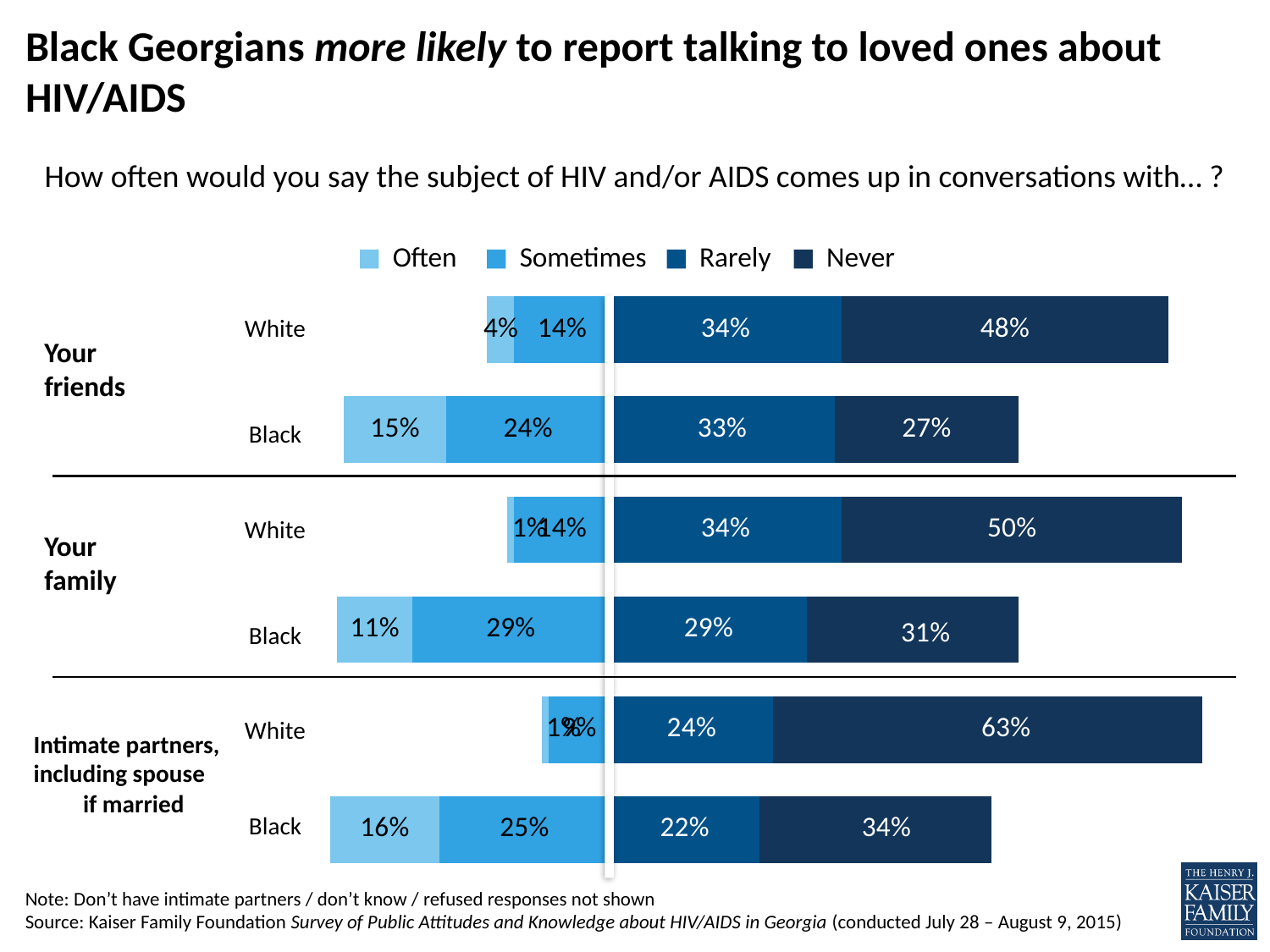
What percentage of White respondents say HIV/AIDS 'Never' comes up in conversations with their friends? 48% What percentage of Black respondents say HIV/AIDS 'Often' comes up in conversations with their friends? 15% What is the difference between the 'Never' shares for White and Black respondents for conversations with friends? 21 percentage points How many series does the legend list? 4 What percentage of Black respondents say HIV/AIDS 'Rarely' comes up in conversations with intimate partners? 22% Which legend entry is shown in the lightest blue colour? Often What percentage of White respondents say HIV/AIDS 'Never' comes up in conversations with intimate partners? 63% Across all six bars, which bar has the highest 'Never' value? Intimate partners, White Which group has the larger 'Never' share for conversations with friends, White or Black respondents? White What is the difference between the 'Often' shares for Black and White respondents for conversations with friends? 11 percentage points What percentage of Black respondents say HIV/AIDS 'Sometimes' comes up in conversations with their family? 29% What kind of chart is shown on the slide? stacked bar chart